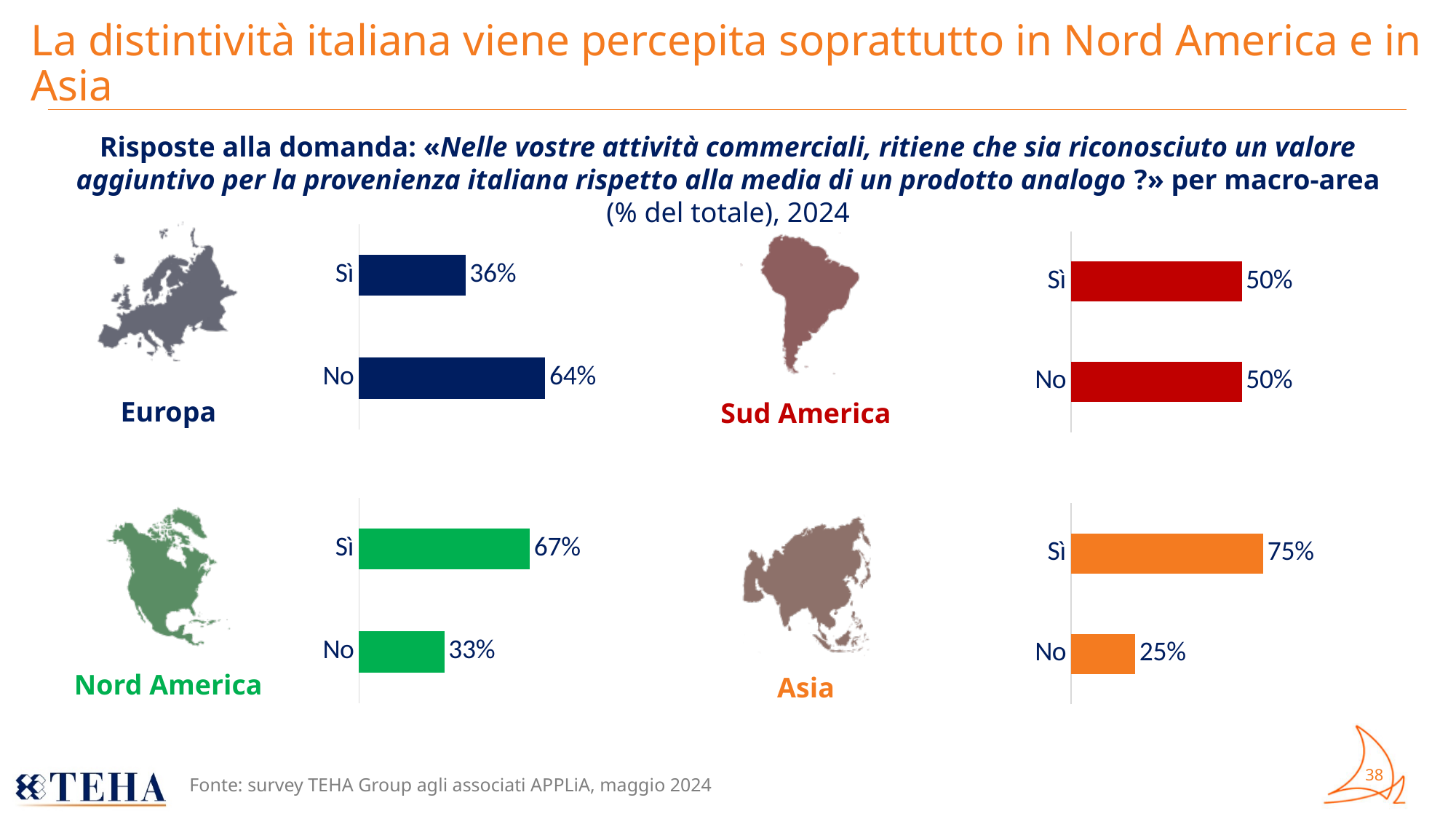
In the Sud America chart, what is the value for Sì? 50% In the Europa chart, what is the value for Sì? 36% In the Nord America chart, which is larger, Sì or No? Sì In the Europa chart, what is the difference between No and Sì? 28% In the Europa chart, which category has the highest value? No What kind of chart is used for the Nord America data? Bar chart What colour are the bars in the Asia chart? Orange In the Nord America chart, what is the value for Sì? 67% In the Europa chart, what is the value for No? 64% In the Asia chart, what is the value for No? 25% How many bars are shown in the Asia chart? 2 In the Asia chart, what is the difference between Sì and No? 50%